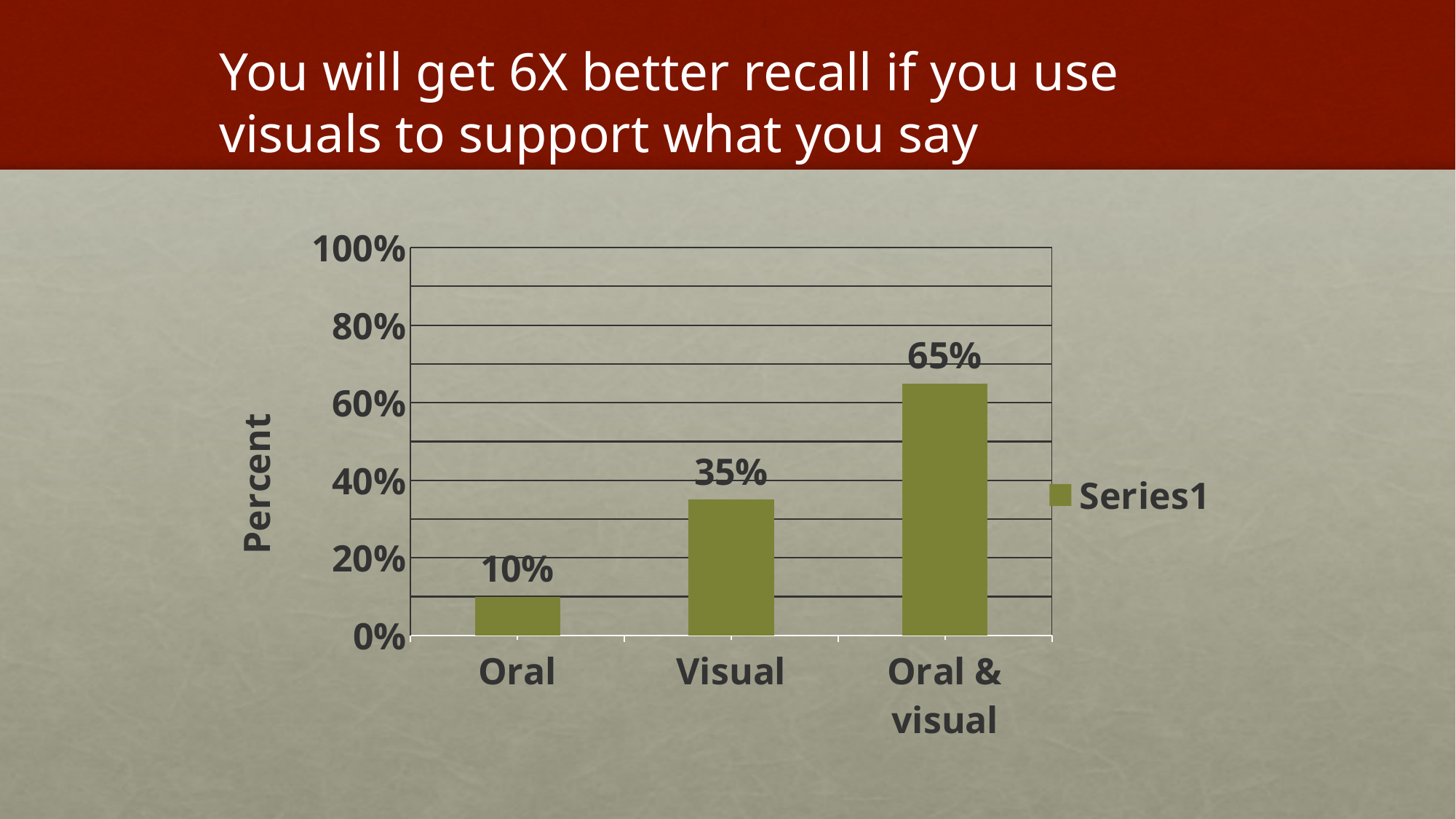
Is the value for Oral & visual greater or less than 60%? greater Which is larger, the value for Visual or the value for Oral? Visual What is the difference between the values for Visual and Oral? 25% Which category has the highest value? Oral & visual What kind of chart is shown on the slide? bar chart What is the label of the y axis? Percent What is the value for Oral & visual? 65% Which category has the lowest value? Oral What is the difference between the values for Oral & visual and Visual? 30% What is the value for Visual? 35% How many categories are shown on the x axis? 3 What is the value for Oral? 10%